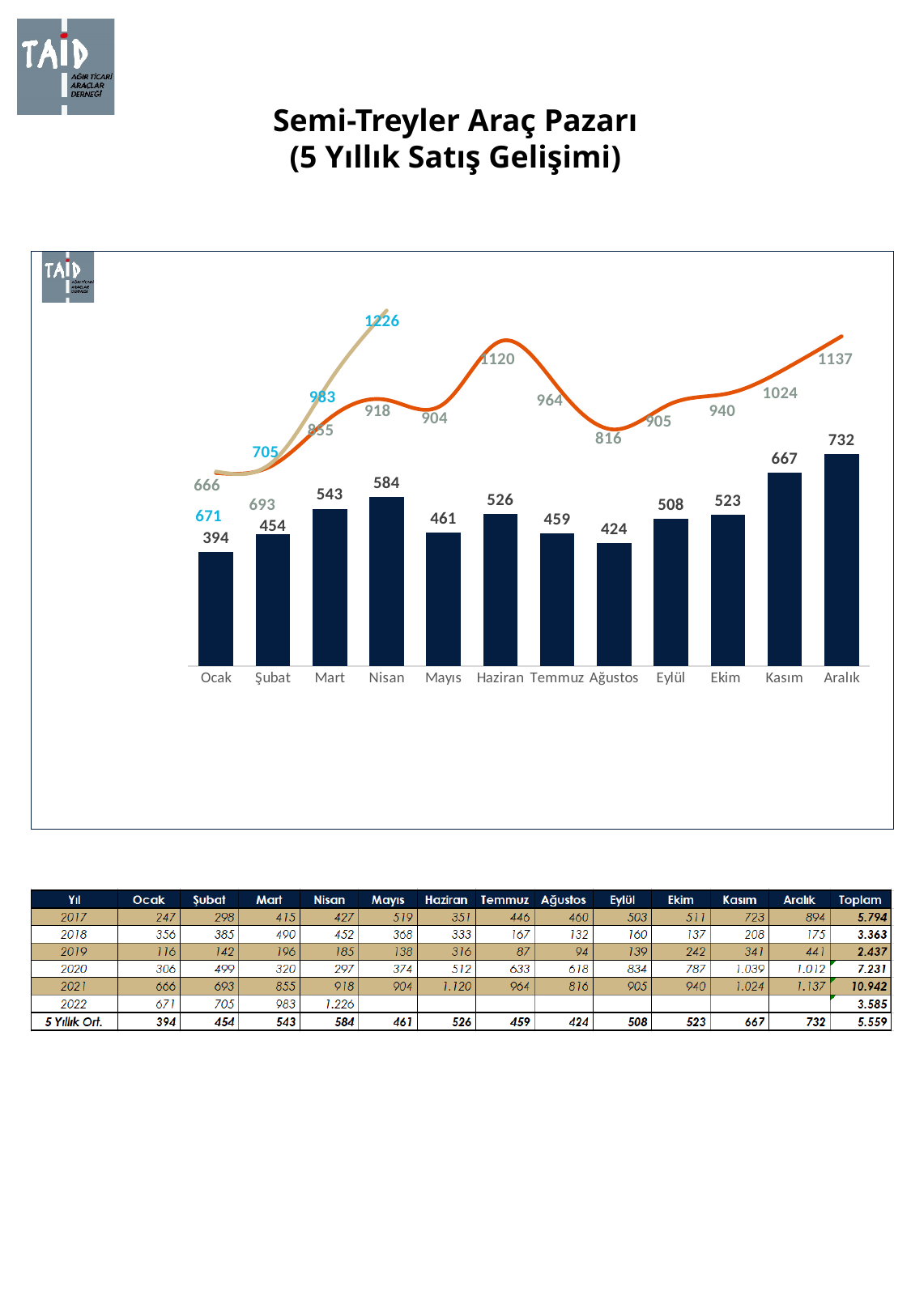
What kind of chart is shown on the slide? Combined bar and line chart Does the orange line rise or fall from Eylül to Aralık? Rises What is the title of the slide? Semi-Treyler Araç Pazarı (5 Yıllık Satış Gelişimi) How many months are shown on the x axis of the chart? 12 What is the difference between the bar values for Aralık and Ocak? 338 At which month does the orange line reach its highest labelled value? Aralık What value is labelled in blue on the upper (tan) line for Nisan? 1226 What is the value of the bar for Nisan? 584 Which bar is taller, Mart or Eylül? Mart What value is labelled on the orange line for Haziran? 1120 Which month has the lowest bar? Ocak Which month has the highest bar? Aralık